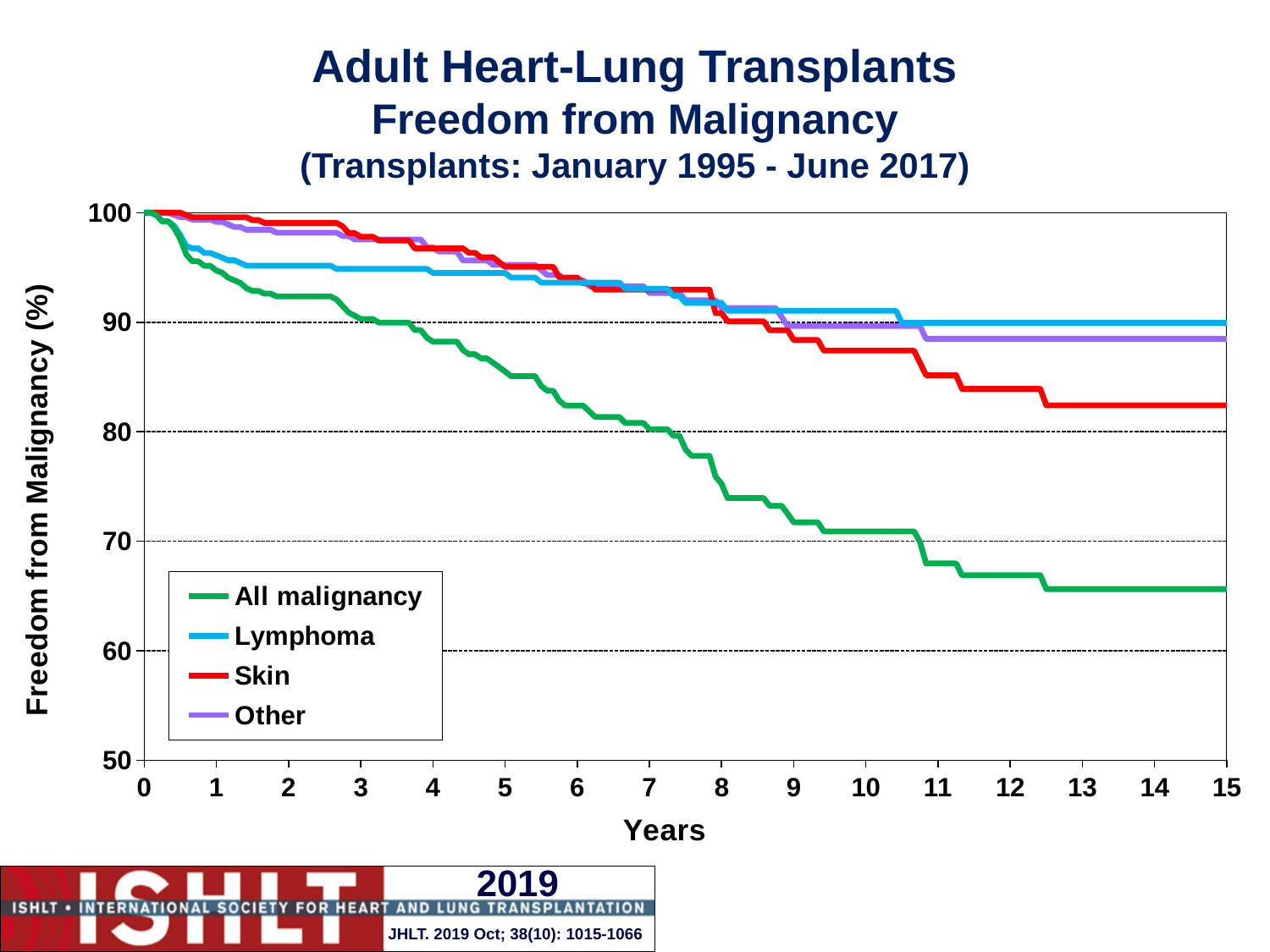
Which series has the lowest freedom from malignancy at 15 years? All malignancy Does the All malignancy curve rise or fall as years increase? Fall What kind of chart is shown on the slide? Line chart Is the value for Lymphoma at 5 years greater or less than 90? greater What is the label of the y axis? Freedom from Malignancy (%) Is the value for All malignancy at 5 years greater or less than 80? greater Is the value for Skin at 15 years greater or less than 80? greater At 15 years, which is larger: the value for Skin or the value for Lymphoma? Lymphoma How many series does the legend list? 4 What colour is the Skin line in the chart? Red